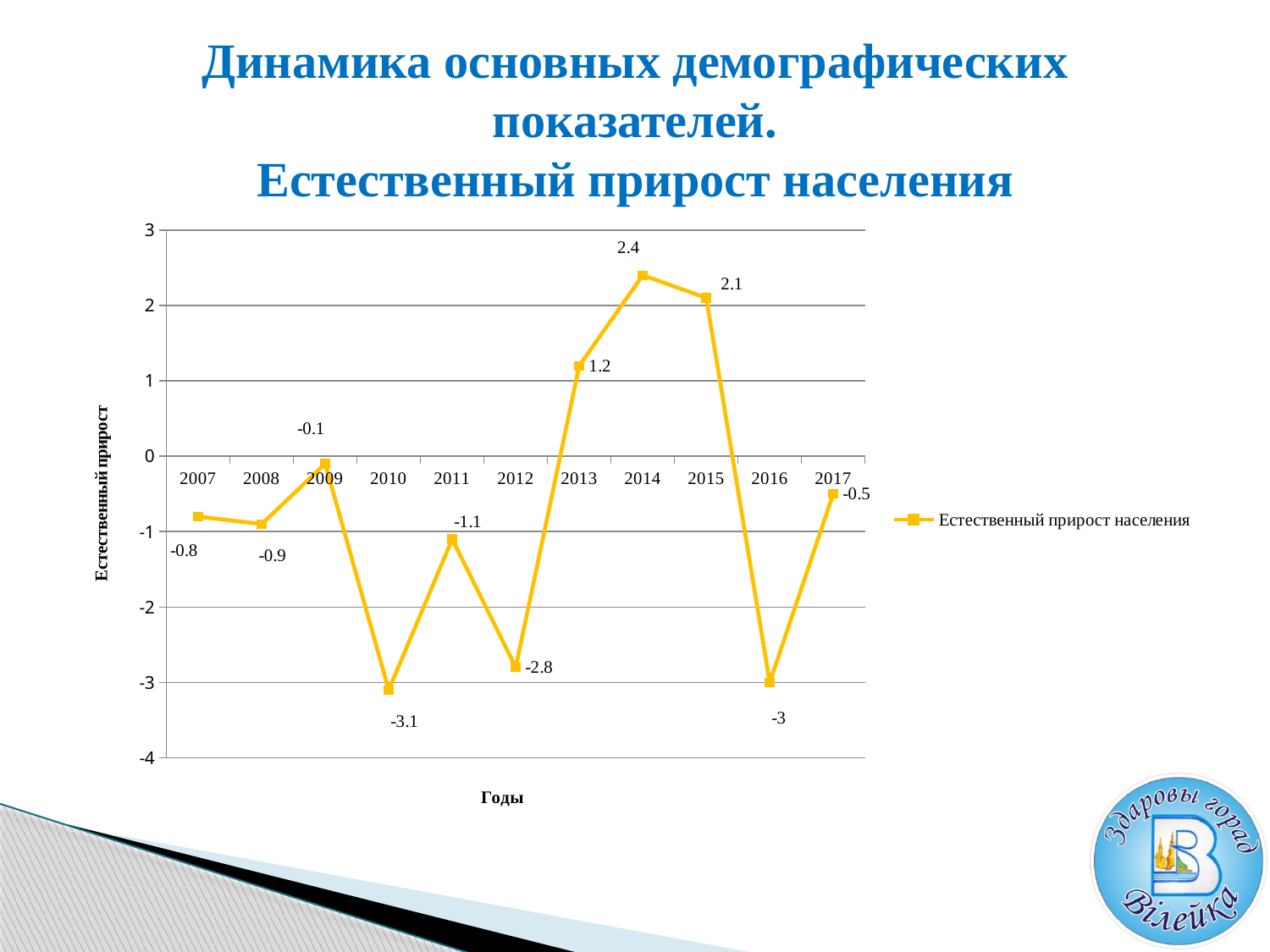
What is the value of natural population growth for 2010? -3.1 Which year has the highest value of natural population growth? 2014 What is the value of natural population growth for 2017? -0.5 What is the label of the x axis? Годы What type of chart is shown on the slide? line chart How many years are plotted on the x axis? 11 What is the value of natural population growth (Естественный прирост населения) for 2014? 2.4 Which year has a larger value of natural population growth, 2013 or 2015? 2015 What is the difference between the values for 2014 and 2015? 0.3 What is the value of natural population growth for 2012? -2.8 Which year has the lowest value of natural population growth? 2010 How many series does the legend list? 1